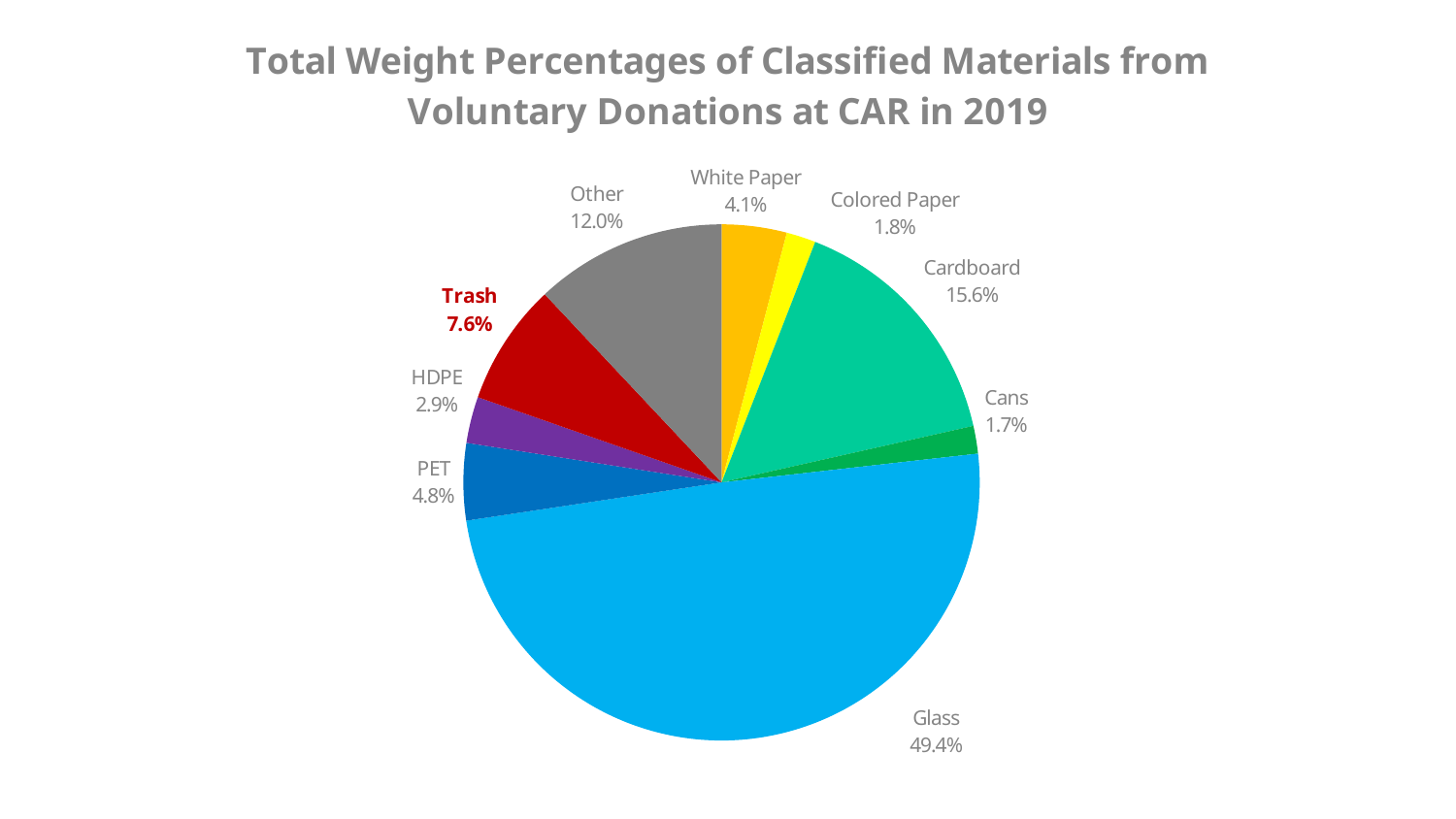
What is the weight percentage for Glass? 49.4% Which material has the smallest share of the pie? Cans Which slice label is shown in red text? Trash How many slices does the pie chart have? 9 What is the weight percentage for Cardboard? 15.6% What is the weight percentage for Trash? 7.6% What is the title of the chart? Total Weight Percentages of Classified Materials from Voluntary Donations at CAR in 2019 Which is larger, the share for PET or the share for White Paper? PET What is the weight percentage for HDPE? 2.9% What kind of chart is shown on the slide? pie chart What is the difference in percentage points between Other and Trash? 4.4 Which material has the largest share of the pie? Glass